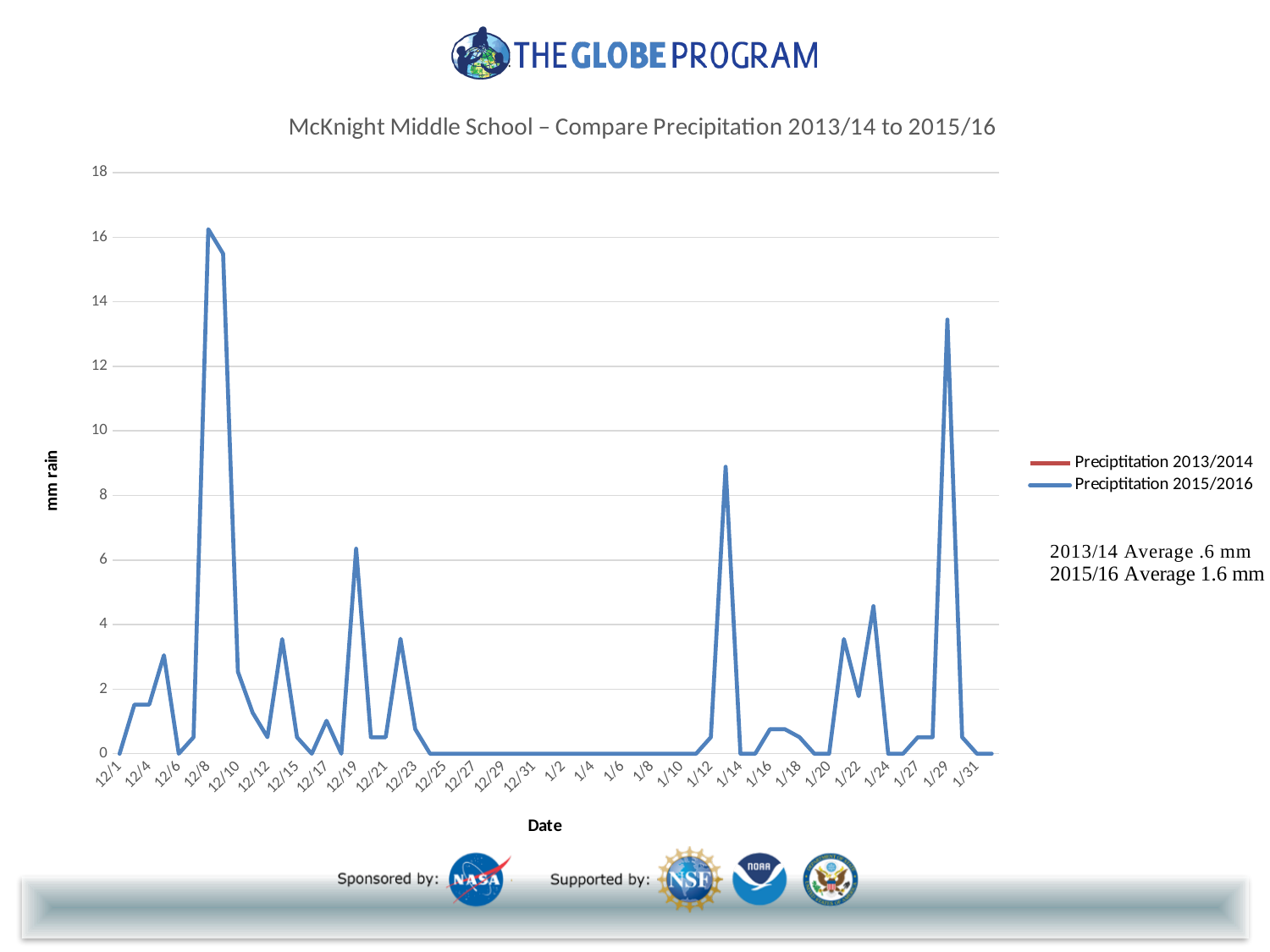
What kind of chart is shown on the slide? line chart Does the Precipitation 2015/2016 series rise or fall between 12/8 and 12/12? fall Is the Precipitation 2015/2016 value on 12/8 greater or less than 14? greater What is the title of the chart? McKnight Middle School – Compare Precipitation 2013/14 to 2015/16 Is the Precipitation 2015/2016 value on 12/27 greater or less than 2? less On which date does the Precipitation 2015/2016 series reach its highest value? 12/8 Is the Precipitation 2015/2016 value on 1/29 greater or less than 12? greater How many series does the chart's legend list? 2 Which has the larger Precipitation 2015/2016 value, 12/8 or 1/29? 12/8 What is the label on the vertical axis of the chart? mm rain